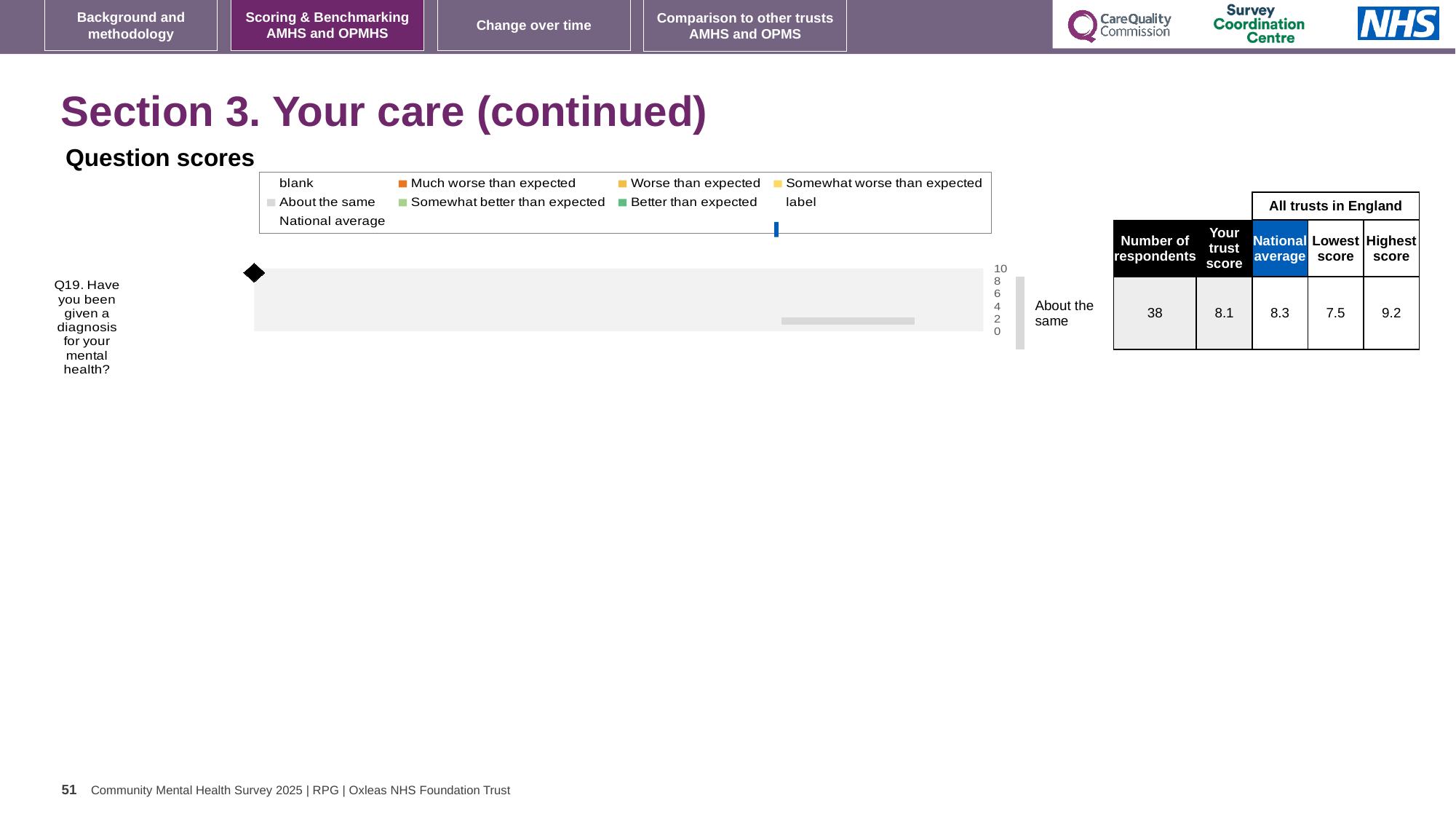
In the table beside the chart, what is the 'Your trust score' for Q19? 8.1 What kind of chart is used to show the Q19 question score? bar chart In the table beside the chart, how many respondents answered Q19? 38 For Q19, which is larger: the trust score or the National average? National average In the table beside the chart, what is the Highest score among all trusts in England for Q19? 9.2 What is the highest value shown on the score axis of the Question scores chart? 10 In the table beside the chart, what is the Lowest score among all trusts in England for Q19? 7.5 Which benchmark category label is shown next to the bar for Q19? About the same For Q19, what is the difference between the Highest score and the Lowest score among all trusts in England? 1.7 How many survey questions are plotted in the Question scores chart? 1 In the table beside the chart, what is the National average score for Q19? 8.3 How many entries does the legend of the Question scores chart list? 9